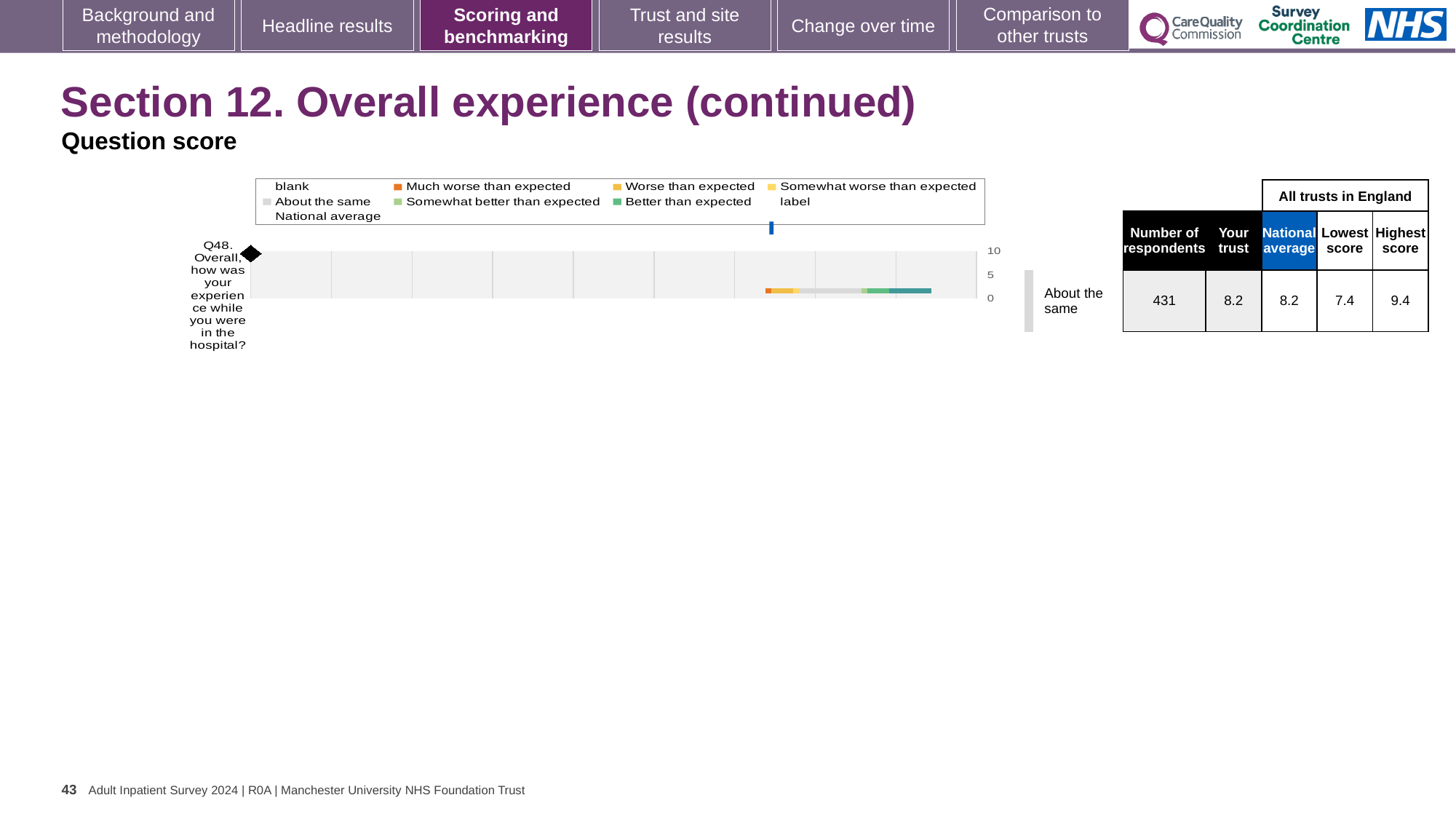
What is the highest value shown on the chart's score axis? 10 What is the lowest score among all trusts in England for Q48? 7.4 What is the 'Your trust' score for Q48 in the table next to the chart? 8.2 Which benchmarking category is the trust's Q48 score placed in? About the same What is the national average score for Q48 in the table next to the chart? 8.2 How many respondents answered Q48? 431 What is the difference between the highest score and the lowest score for Q48? 2.0 Is the 'Your trust' score for Q48 greater than, less than, or equal to the national average? equal How many questions (categories) are plotted in the chart? 1 What kind of chart is shown on the slide? bar chart What is the highest score among all trusts in England for Q48? 9.4 Which question is plotted in the chart? Q48. Overall, how was your experience while you were in the hospital?